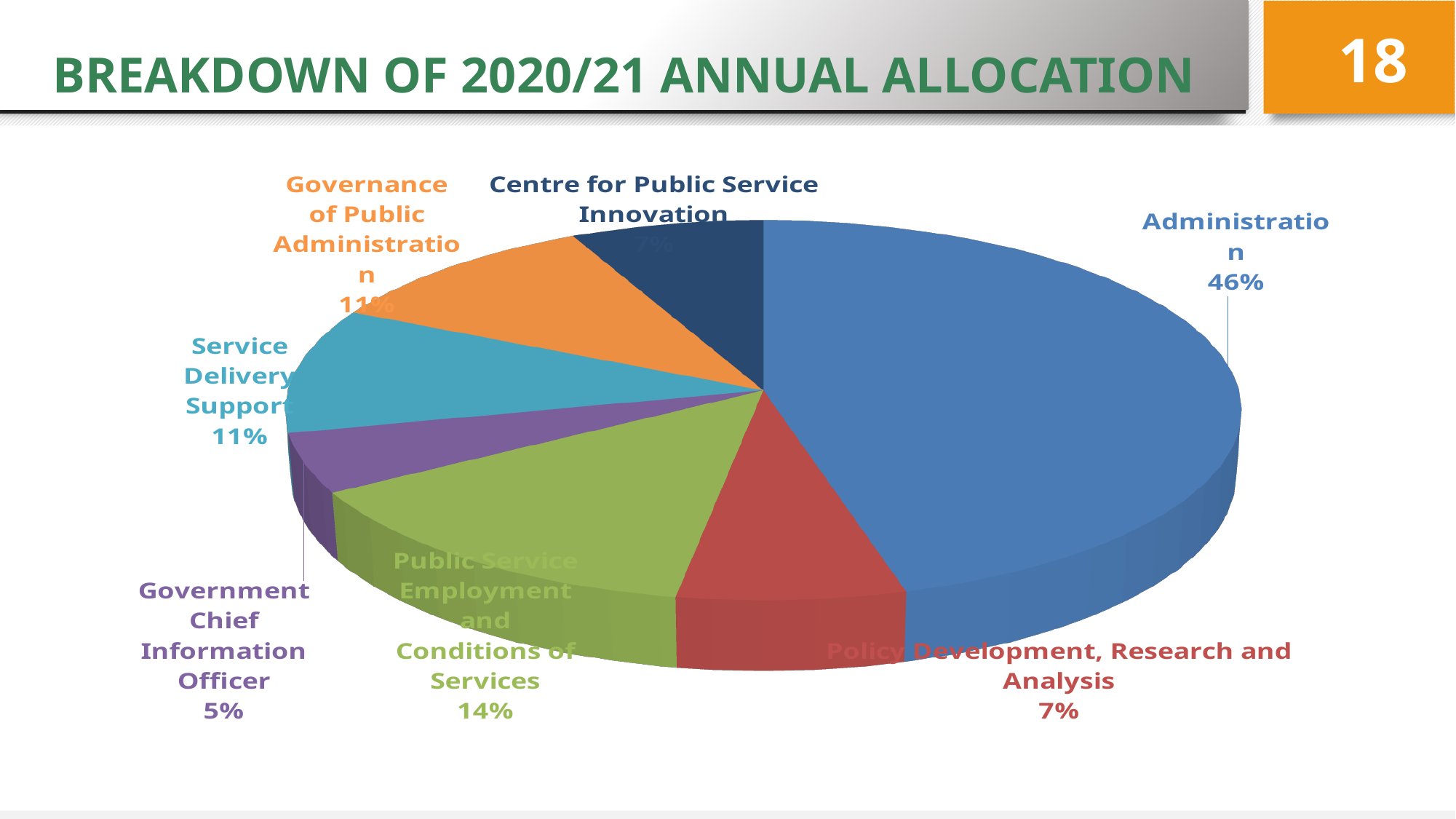
Which receives a larger share: Service Delivery Support or Policy Development, Research and Analysis? Service Delivery Support Which programme receives the smallest share of the allocation? Government Chief Information Officer What is the title of the slide containing the chart? BREAKDOWN OF 2020/21 ANNUAL ALLOCATION What percentage of the allocation goes to the Government Chief Information Officer? 5% What type of chart is shown on the slide? Pie chart What share of the allocation is for Service Delivery Support? 11% What is the difference in percentage points between Administration and Public Service Employment and Conditions of Services? 32 percentage points Which programme receives the largest share of the 2020/21 annual allocation? Administration How many slices does the pie chart have? 7 What percentage is allocated to Policy Development, Research and Analysis? 7% What percentage of the allocation is for Public Service Employment and Conditions of Services? 14% What share of the 2020/21 annual allocation goes to Administration? 46%